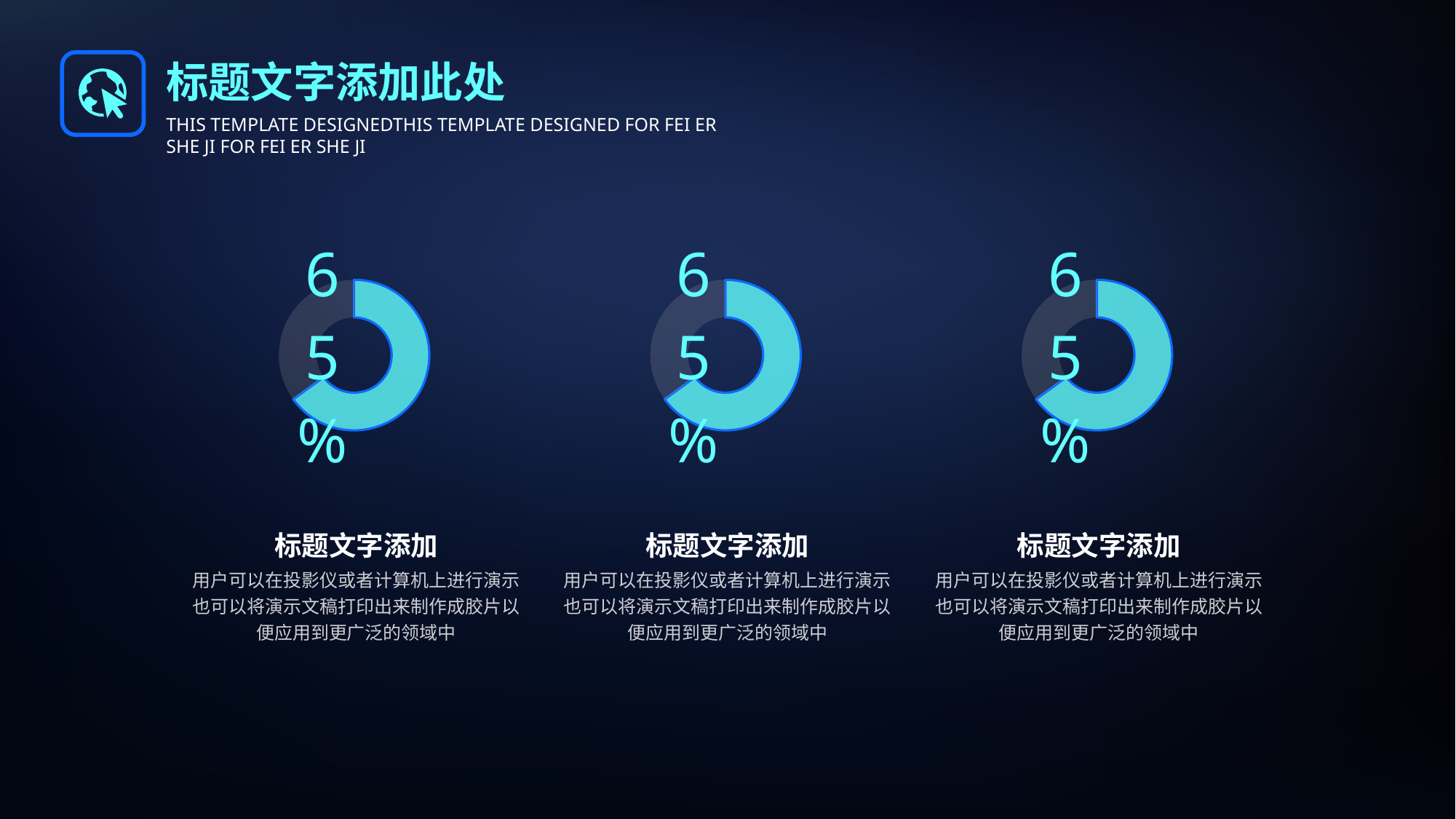
What is the caption printed below the middle donut chart? 标题文字添加 In the right donut chart, is the highlighted value greater or less than 50%? greater What colour is the highlighted segment in each donut chart? Cyan How many donut charts are on the slide? 3 In the middle donut chart, is the highlighted segment larger or smaller than the remaining dark segment? larger Do the three donut charts show the same percentage value? Yes In the left donut chart, what share of the ring does the highlighted cyan segment represent? 65% What kind of chart is shown on the left of the slide? Donut chart In the right donut chart, what percentage is printed in the centre? 65% In the middle donut chart, what percentage is printed in the centre? 65% In the left donut chart, what percentage is printed in the centre? 65%